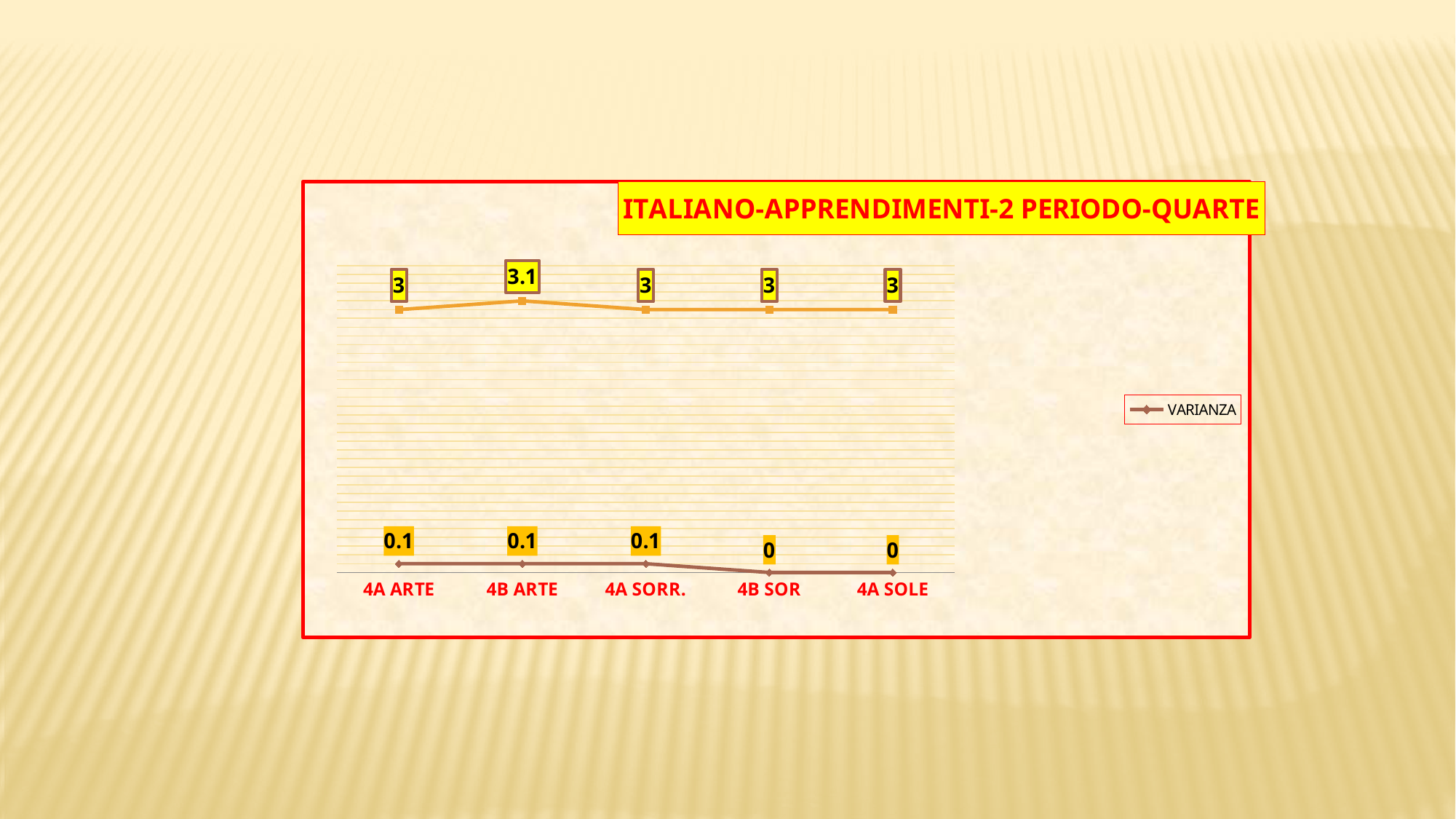
What is the value of the upper orange line for 4A SORR.? 3 What is the difference between the VARIANZA values for 4A SORR. and 4B SOR? 0.1 How many categories are shown on the x axis? 5 What type of chart is shown on the slide? line chart What is the title of the chart? ITALIANO-APPRENDIMENTI-2 PERIODO-QUARTE Does the VARIANZA line rise or fall from 4A SORR. to 4B SOR? fall Which category has the highest value on the upper orange line? 4B ARTE What is the VARIANZA value for 4A SOLE? 0 What is the VARIANZA value for 4B SOR? 0 How many series does the legend list? 1 What is the value of the upper orange line for 4B ARTE? 3.1 What is the VARIANZA value for 4A ARTE? 0.1